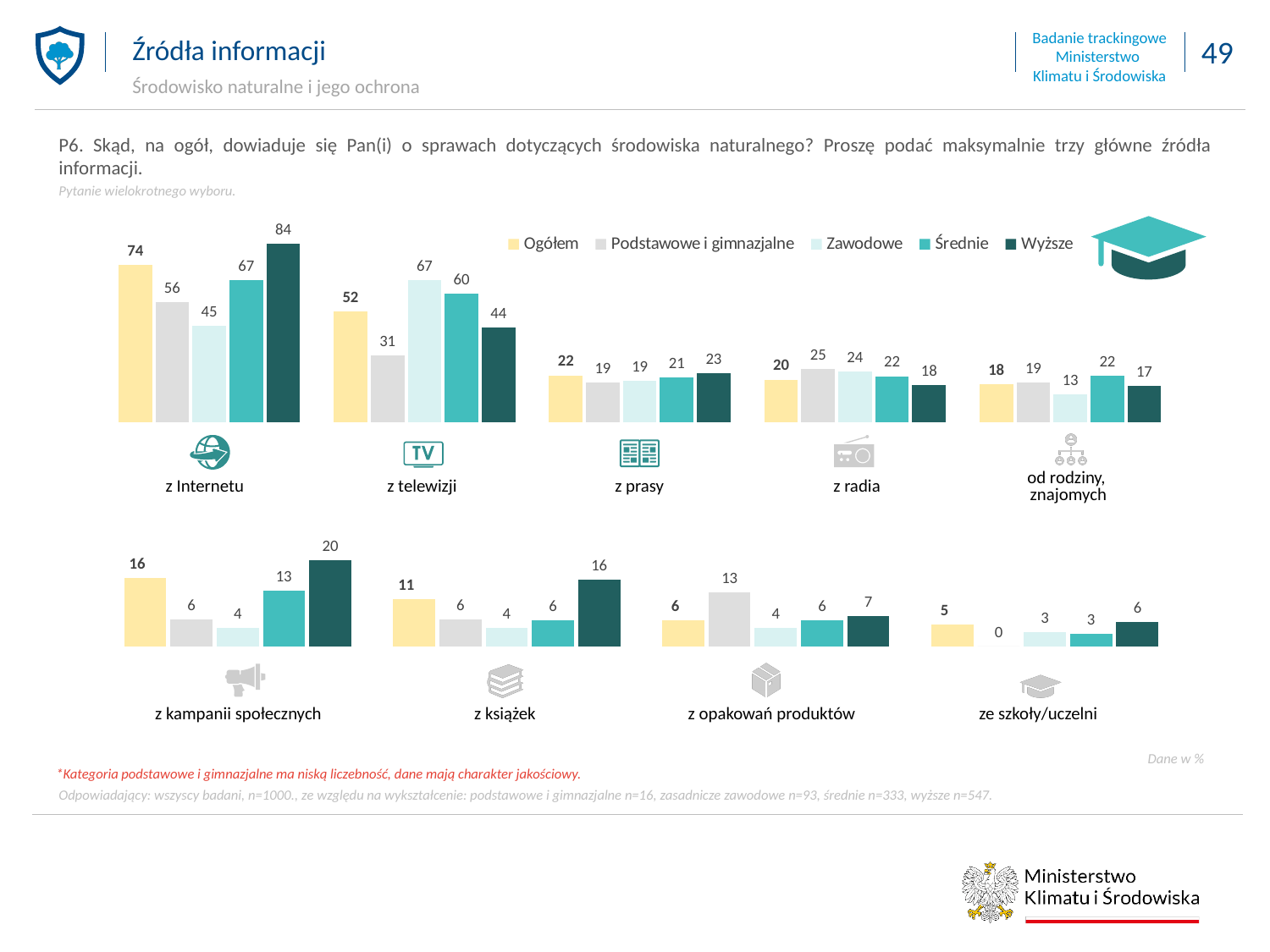
What is the value for Wyższe for the category 'z telewizji'? 44 How many series does the legend list? 5 What is the difference between the Ogółem values for 'z Internetu' and 'z telewizji'? 22 What kind of chart is shown on the slide? Bar chart Which series is shown in yellow in the legend? Ogółem What is the difference between the Wyższe and Zawodowe values for 'z Internetu'? 39 What is the value for Podstawowe i gimnazjalne for the category 'ze szkoły/uczelni'? 0 Which category has the lowest Ogółem value? ze szkoły/uczelni For 'z telewizji', which is larger: the Zawodowe value or the Średnie value? Zawodowe Which category has the highest Ogółem value? z Internetu How many source categories are shown on the slide? 9 What is the value for Ogółem for the category 'z Internetu'? 74